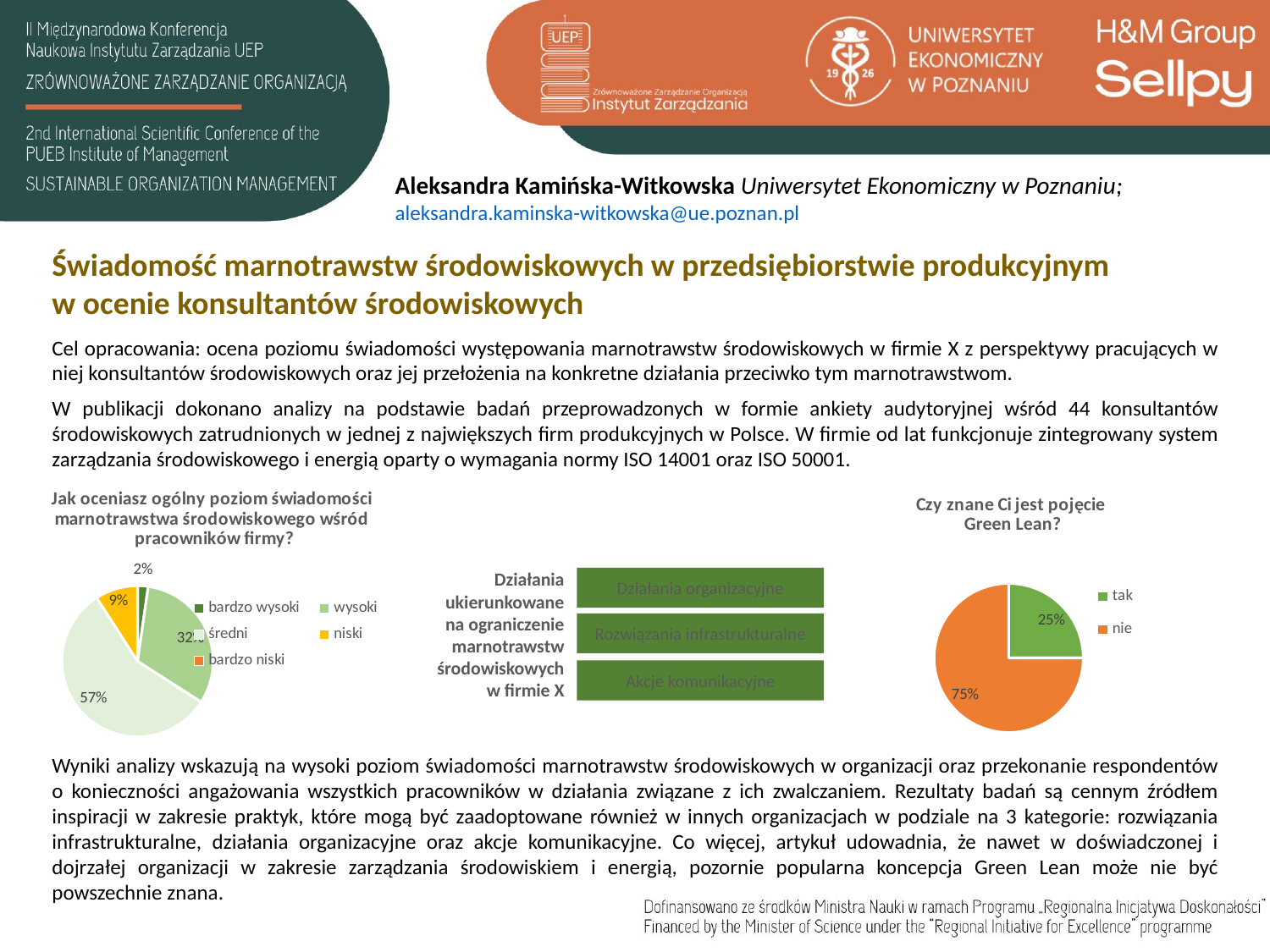
What type of chart is used for 'Czy znane Ci jest pojęcie Green Lean?' pie chart How many entries does the legend of the 'Czy znane Ci jest pojęcie Green Lean?' chart list? 2 In the 'Czy znane Ci jest pojęcie Green Lean?' chart, what percentage answered 'tak'? 25% In the 'Jak oceniasz ogólny poziom świadomości...' chart, what is the share for 'niski'? 9% In the 'Czy znane Ci jest pojęcie Green Lean?' chart, what is the difference between the 'nie' and 'tak' shares? 50% In the 'Jak oceniasz ogólny poziom świadomości...' chart, what is the largest percentage shown? 57% How many categories does the legend of the 'Jak oceniasz ogólny poziom świadomości...' chart list? 5 What type of chart is used for 'Jak oceniasz ogólny poziom świadomości marnotrawstwa środowiskowego wśród pracowników firmy?' pie chart In the 'Czy znane Ci jest pojęcie Green Lean?' chart, which answer has the larger share? nie In the 'Jak oceniasz ogólny poziom świadomości...' chart, what is the share for 'bardzo wysoki'? 2% In the 'Jak oceniasz ogólny poziom świadomości...' chart, which is larger: the 'niski' slice or the 'bardzo wysoki' slice? niski In the 'Czy znane Ci jest pojęcie Green Lean?' chart, what percentage answered 'nie'? 75%